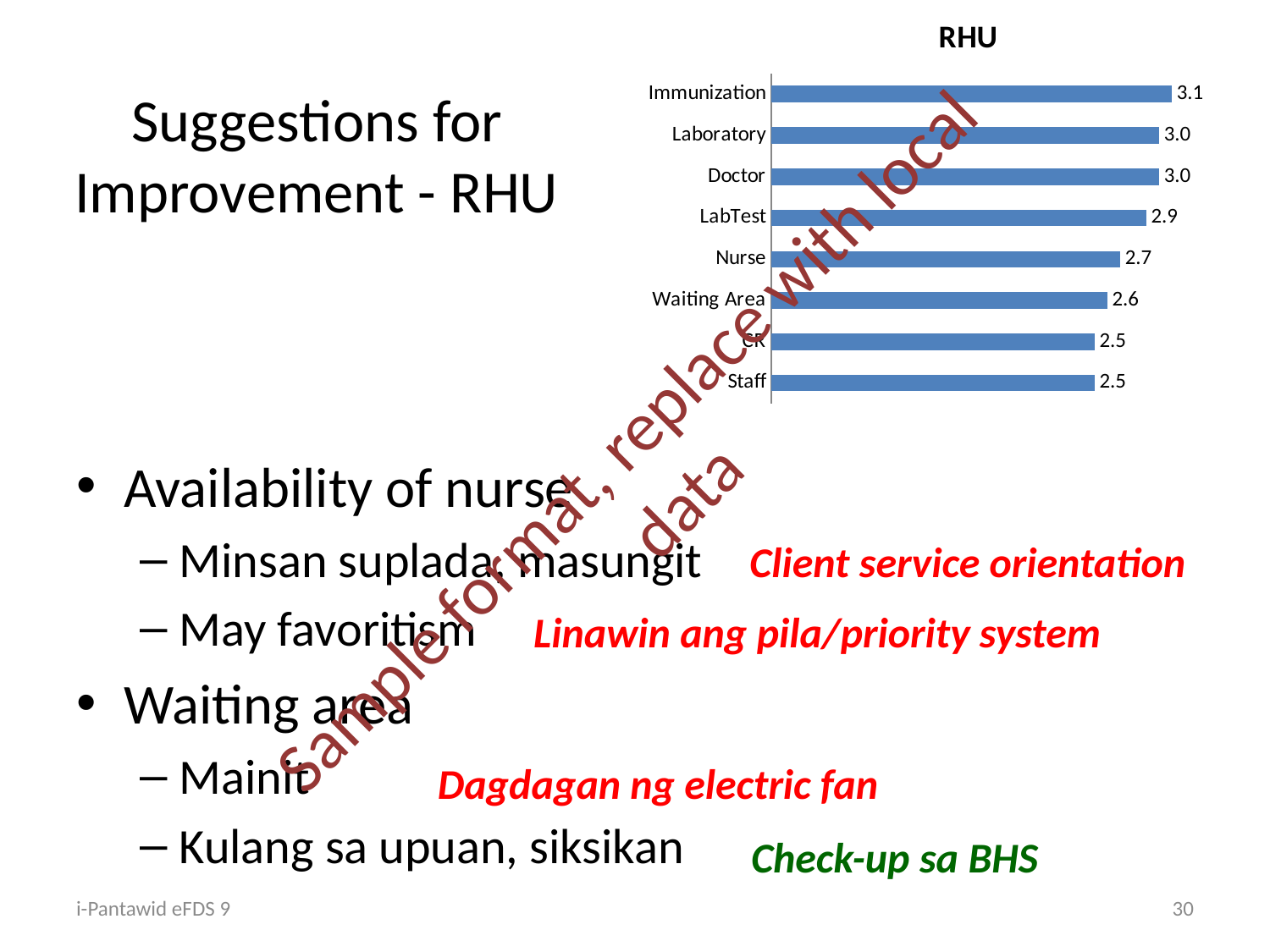
What is the value for Immunization? 3.1 What type of chart is shown on the slide? bar chart What is the value for Nurse? 2.7 How many categories are plotted in the chart? 8 Which category has the highest value? Immunization Which is larger, the value for Doctor or the value for Nurse? Doctor What is the value for LabTest? 2.9 What is the difference between the values for LabTest and Waiting Area? 0.3 What is the difference between the values for Immunization and Staff? 0.6 What is the value for Waiting Area? 2.6 What is the title of the chart? RHU What is the value for Staff? 2.5